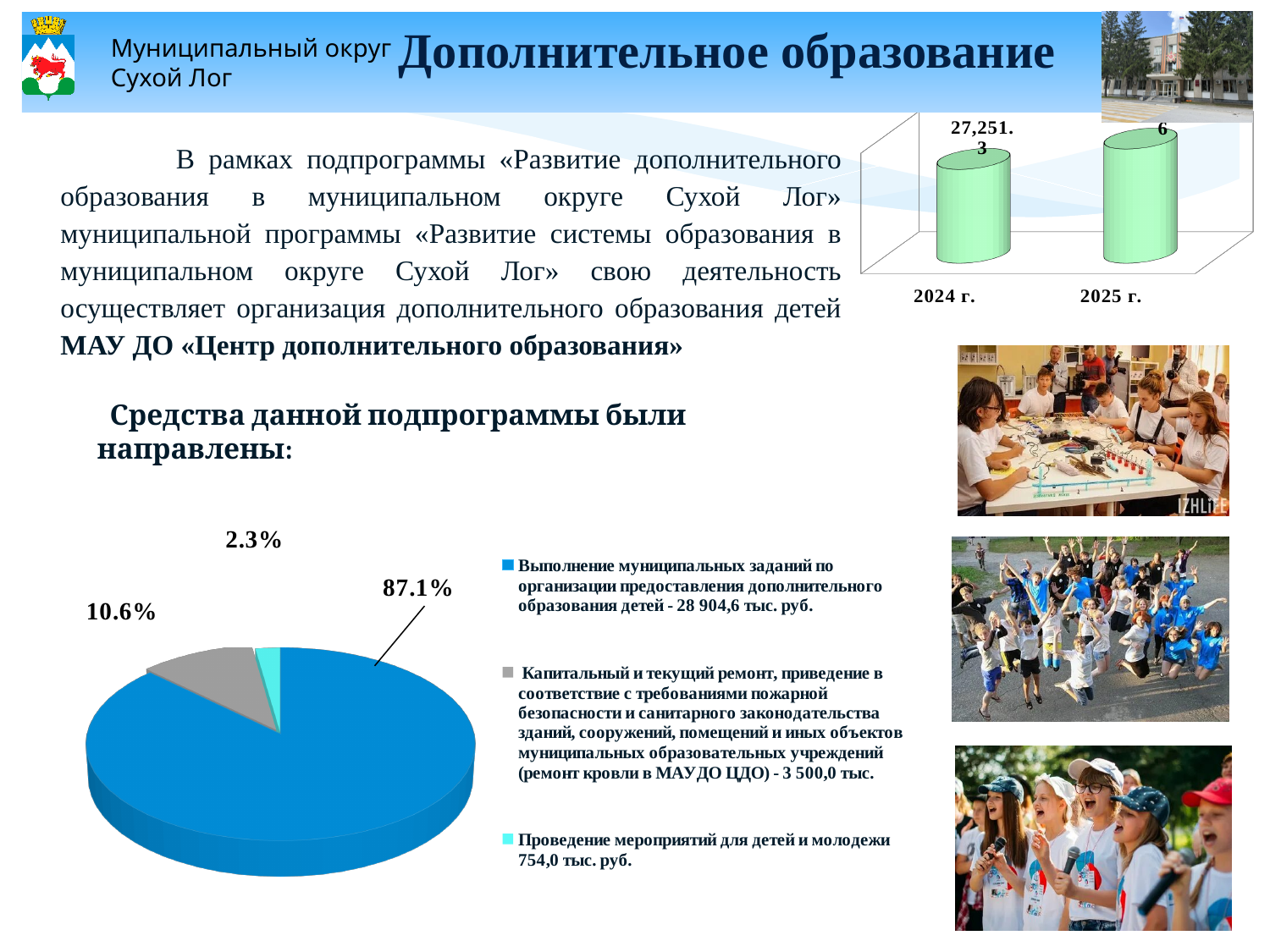
In the bar chart at the top right of the slide, which year has the taller bar, 2024 г. or 2025 г.? 2025 г. In the bar chart at the top right of the slide, what is the value shown for 2024 г.? 27,251.3 In the pie chart at the bottom left of the slide, what is the difference in percentage points between the 87.1% slice and the 10.6% slice? 76.5 In the pie chart at the bottom left of the slide, what percentage is shown for the grey slice (Капитальный и текущий ремонт)? 10.6% In the pie chart at the bottom left of the slide, what percentage is shown for Проведение мероприятий для детей и молодежи? 2.3% How many entries does the legend of the pie chart at the bottom left of the slide list? 3 In the bar chart at the top right of the slide, do the values rise or fall from 2024 г. to 2025 г.? Rise How many bars are plotted in the bar chart at the top right of the slide? 2 What kind of chart is shown at the bottom left of the slide? Pie chart What kind of chart is shown at the top right of the slide? Bar chart In the pie chart at the bottom left of the slide, what share is shown for the largest slice? 87.1% In the pie chart at the bottom left of the slide, which legend category has the smallest slice? Проведение мероприятий для детей и молодежи